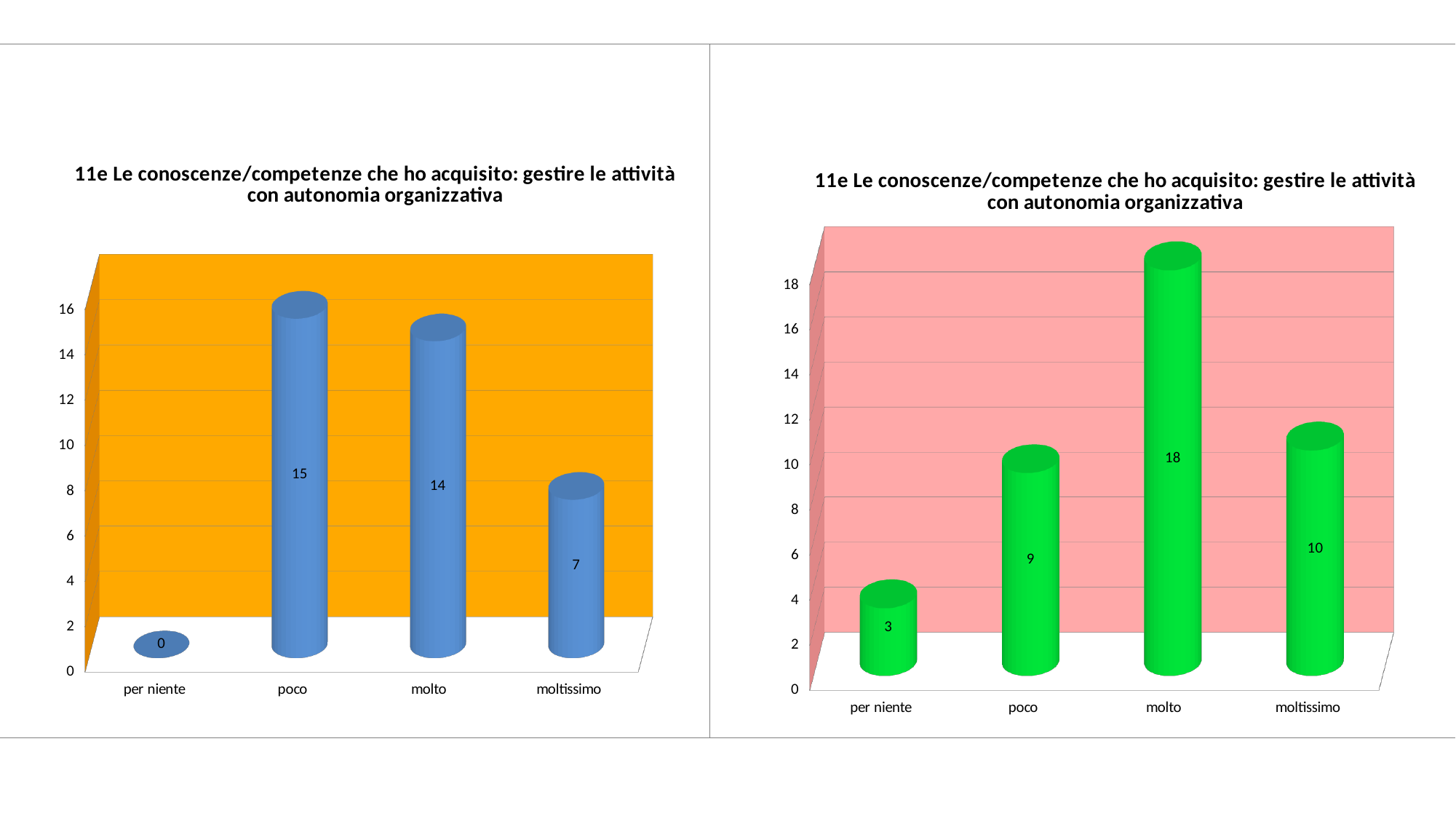
What kind of chart is the left chart? bar chart In the right chart, what is the total of all four values? 40 In the right chart, what is the difference between the values for "molto" and "moltissimo"? 8 In the left chart, what is the value for "poco"? 15 In the right chart, which category has the lowest value? per niente In the left chart, which category has the highest value? poco What colour are the bars in the right chart? green In the right chart, which is larger, the value for "poco" or the value for "moltissimo"? moltissimo In the right chart, what is the value for "molto"? 18 How many categories are shown on the x axis of the right chart? 4 In the left chart, what is the value for "per niente"? 0 In the left chart, what is the difference between the values for "molto" and "moltissimo"? 7